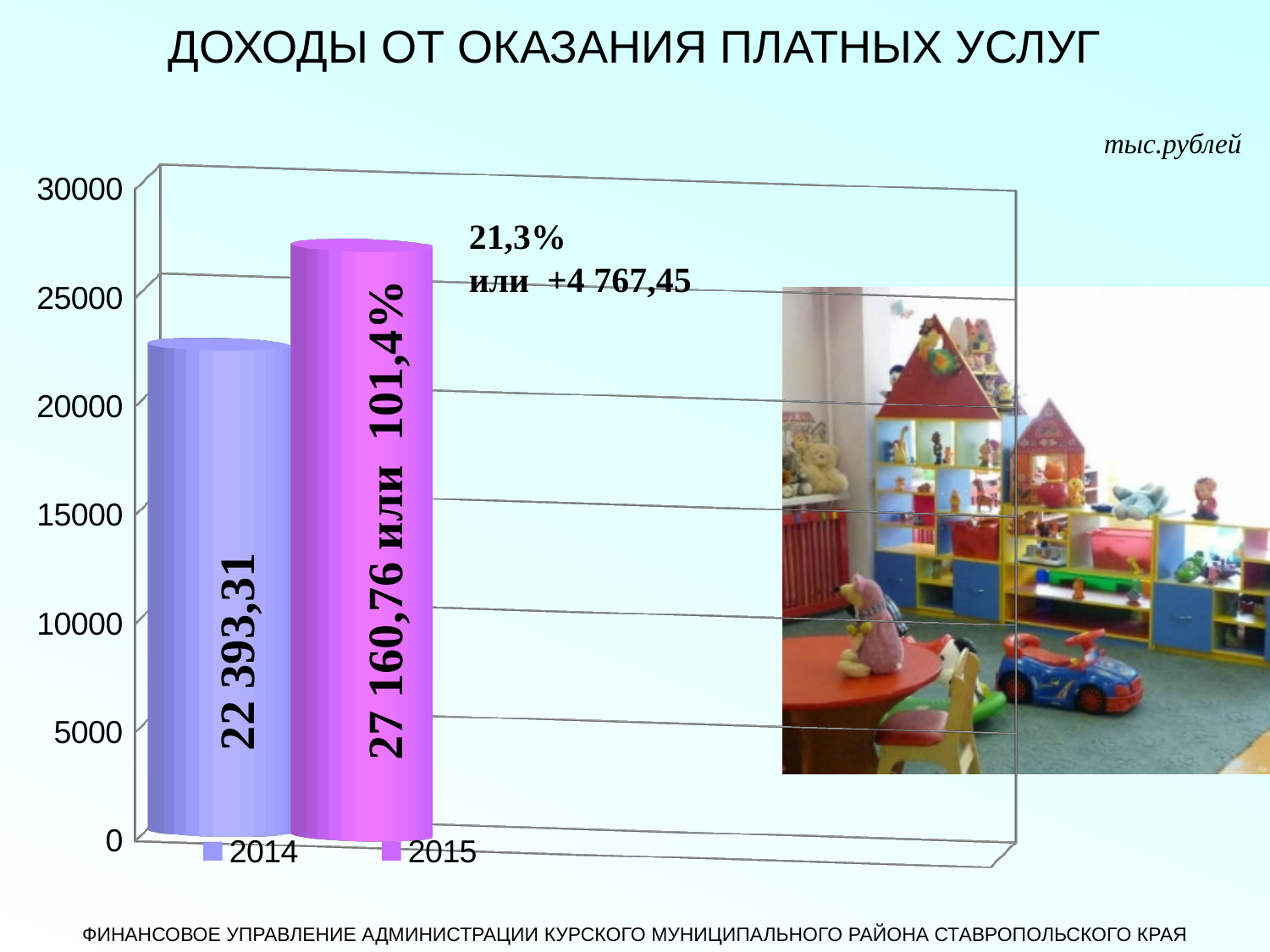
How many bars are plotted on the chart? 2 Is the value for 2014 greater or less than 25000? less What is the difference between the 2015 and 2014 values, as printed on the slide? +4 767,45 Is the value for 2015 greater or less than 25000? greater What is the value for 2015? 27 160,76 Which year has the lowest value? 2014 Which year has the higher value, 2014 or 2015? 2015 What unit is indicated for the chart values? тыс.рублей What is the value for 2014? 22 393,31 What percentage is printed on the 2015 bar after 'или'? 101,4% What type of chart is shown? bar chart By what percentage did the value grow from 2014 to 2015, according to the annotation? 21,3%